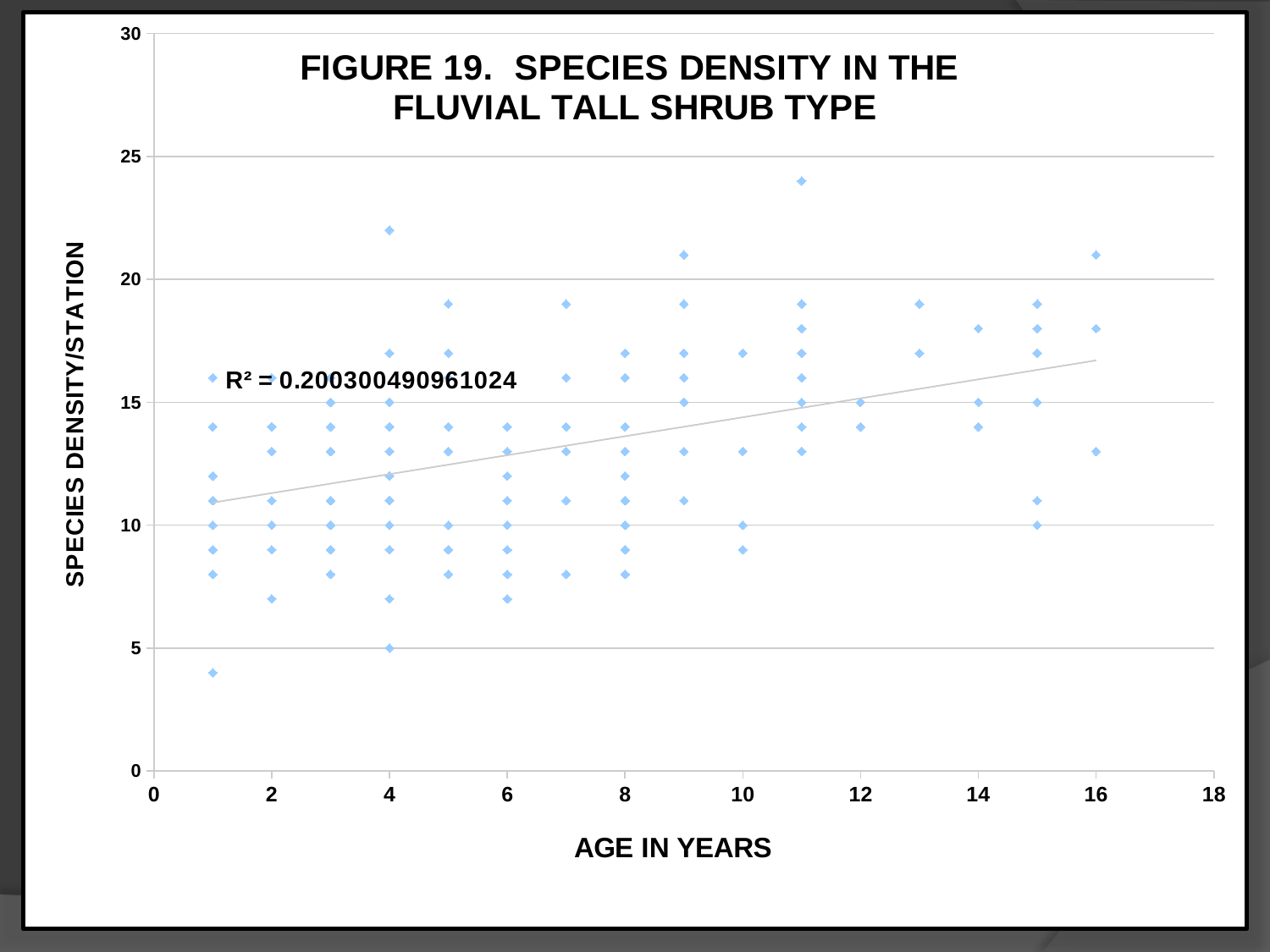
Is the highest value at age 16 greater or less than 20? greater Is the highest point at age 11 higher or lower than the highest point at age 4? Higher What R² value is printed on the chart? R² = 0.200300490961024 What is the label of the x axis? AGE IN YEARS What kind of chart is shown on the slide? Scatter plot What is the title of the chart? FIGURE 19. SPECIES DENSITY IN THE FLUVIAL TALL SHRUB TYPE Is the lowest value at age 1 greater or less than 5? less Is the highest value at age 11 greater or less than 20? greater At which age in years is the single lowest species density point plotted? 1 At which age in years is the single highest species density point plotted? 11 Does the trend line rise or fall as age in years increases? Rises What is the lowest species density value plotted at age 4? 5